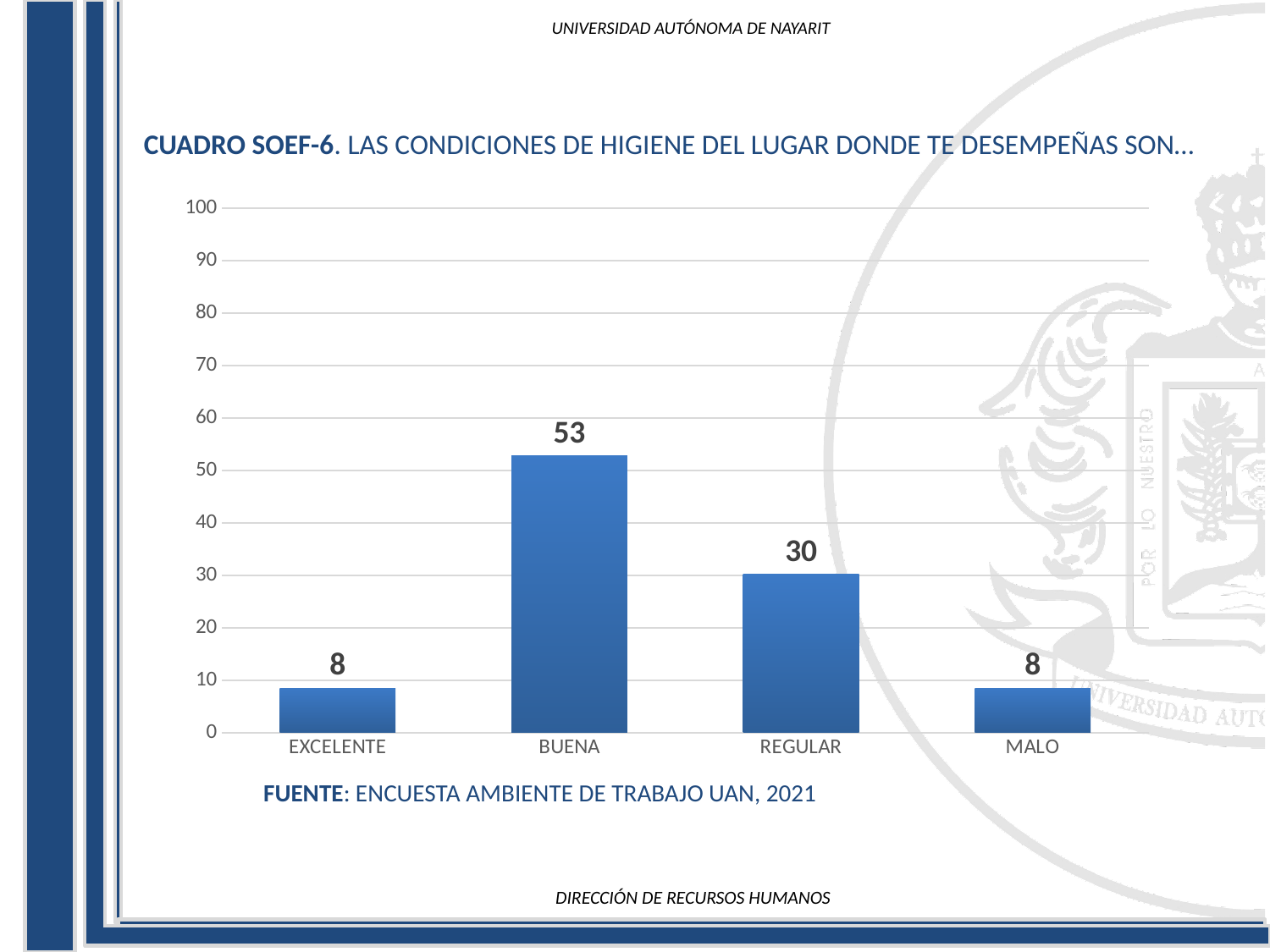
Which category has the highest value? BUENA What is the value for BUENA? 53 What source is cited below the chart? ENCUESTA AMBIENTE DE TRABAJO UAN, 2021 What is the value for MALO? 8 How many categories are shown on the x axis? 4 What is the value for REGULAR? 30 What is the value for EXCELENTE? 8 Is the value for REGULAR greater or less than 40? less What is the difference between the values for REGULAR and MALO? 22 What kind of chart is shown on the slide? bar chart What is the difference between the values for BUENA and REGULAR? 23 Which is larger, the value for BUENA or the value for REGULAR? BUENA